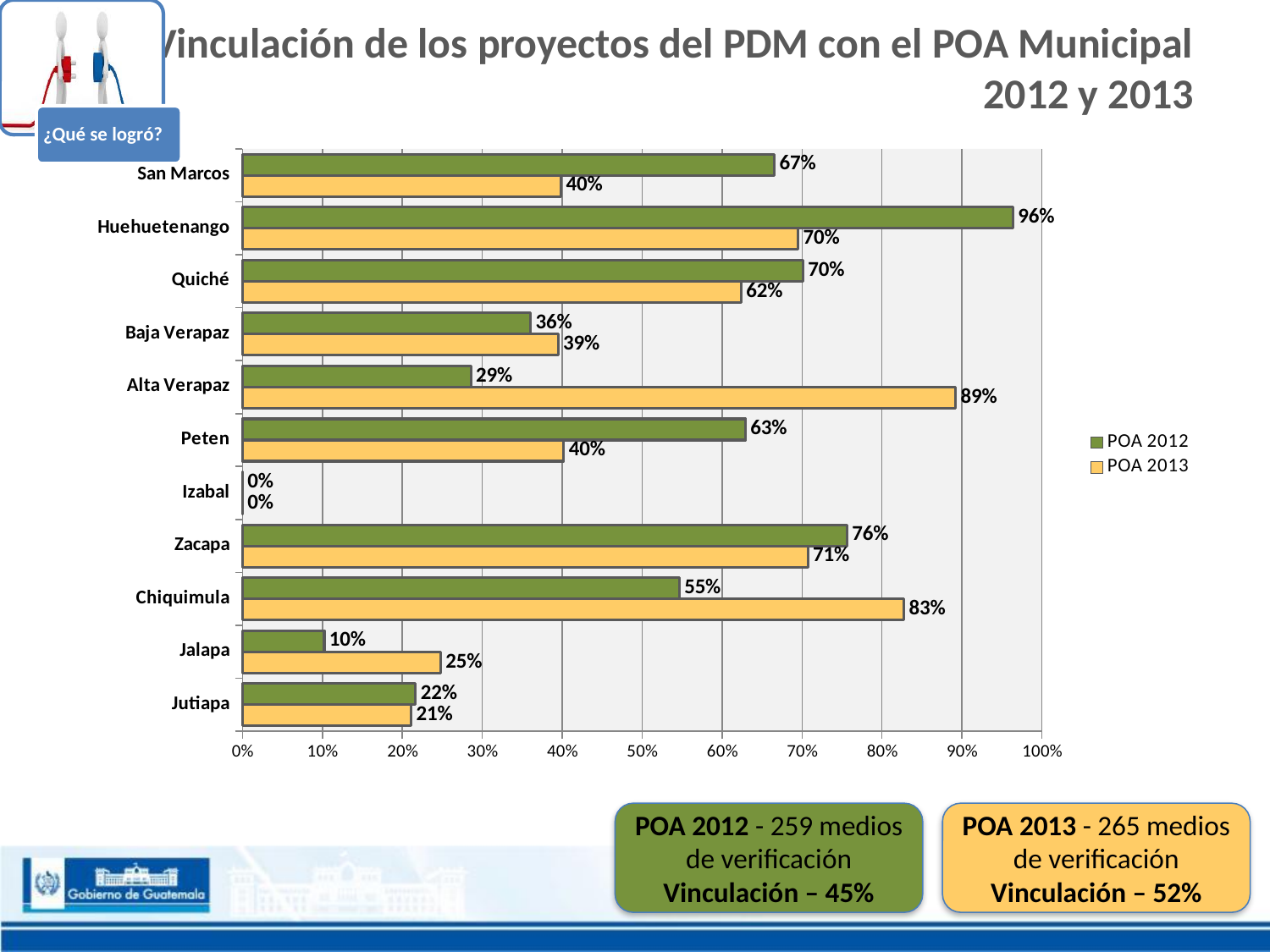
How many series does the legend list? 2 What is the difference between the POA 2012 values for Zacapa and Jutiapa? 54% What is the POA 2013 value for Jalapa? 25% What is the difference between the POA 2013 and POA 2012 values for Alta Verapaz? 60% What is the POA 2012 value for Huehuetenango? 96% Which is larger for Chiquimula, the POA 2012 value or the POA 2013 value? POA 2013 What is the POA 2013 value for Alta Verapaz? 89% What kind of chart is shown on the slide? Bar chart Which department has the highest POA 2012 value? Huehuetenango Which colour represents POA 2013 in the legend? Yellow Which department has the lowest POA 2013 value? Izabal How many departments are shown on the chart? 11